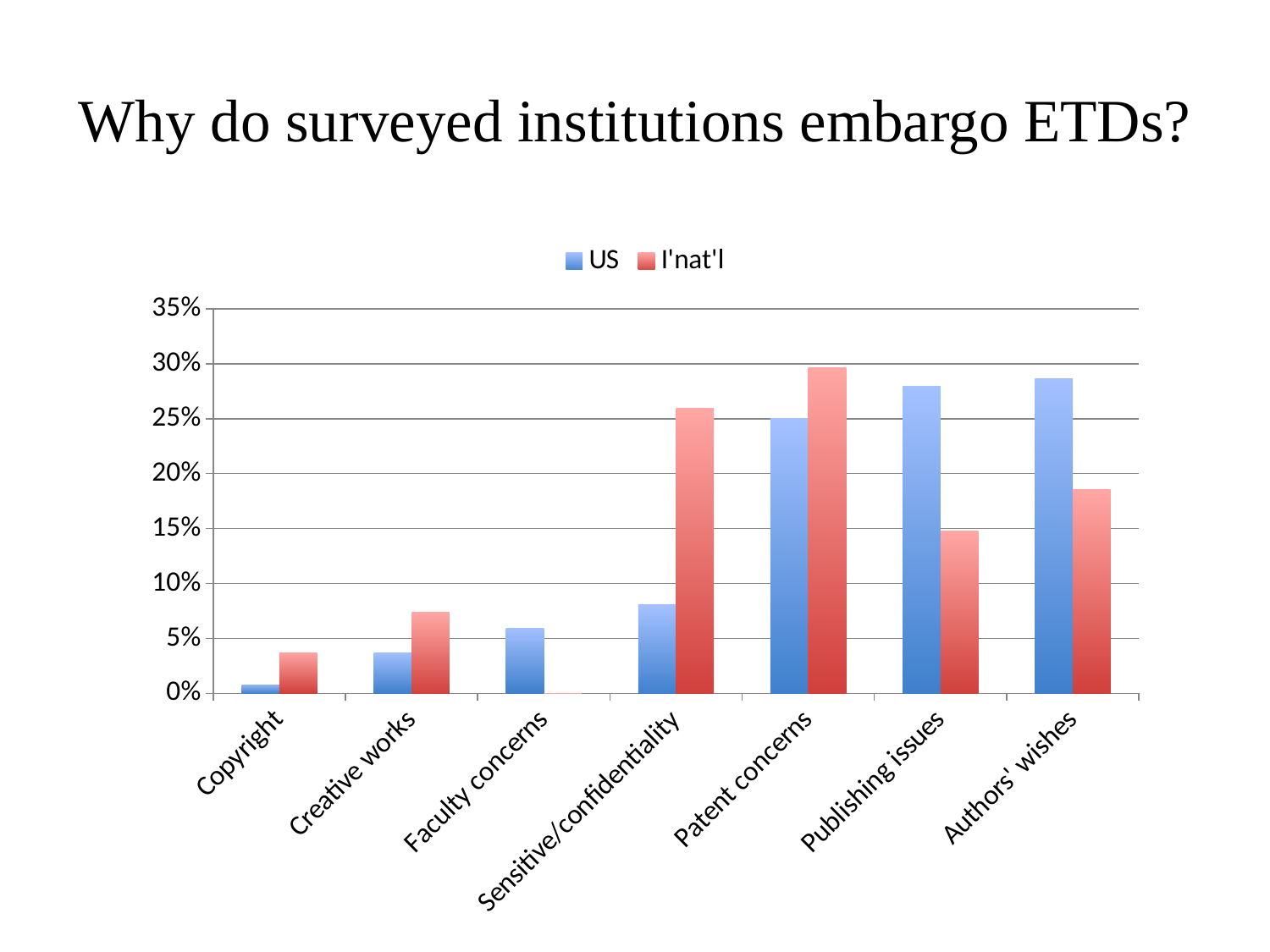
Is the I'nat'l value for Authors' wishes greater or less than 20%? less Which category has the highest I'nat'l value? Patent concerns Is the I'nat'l value for Sensitive/confidentiality greater or less than 25%? greater Which category has the lowest I'nat'l value? Faculty concerns Which category has the lowest US value? Copyright What kind of chart is shown on the slide? bar chart Is the US value for Publishing issues greater or less than 25%? greater For Sensitive/confidentiality, which series has the larger value, US or I'nat'l? I'nat'l For Publishing issues, which series has the larger value, US or I'nat'l? US How many categories are shown on the x axis? 7 How many series does the legend list? 2 What is the title of the slide? Why do surveyed institutions embargo ETDs?